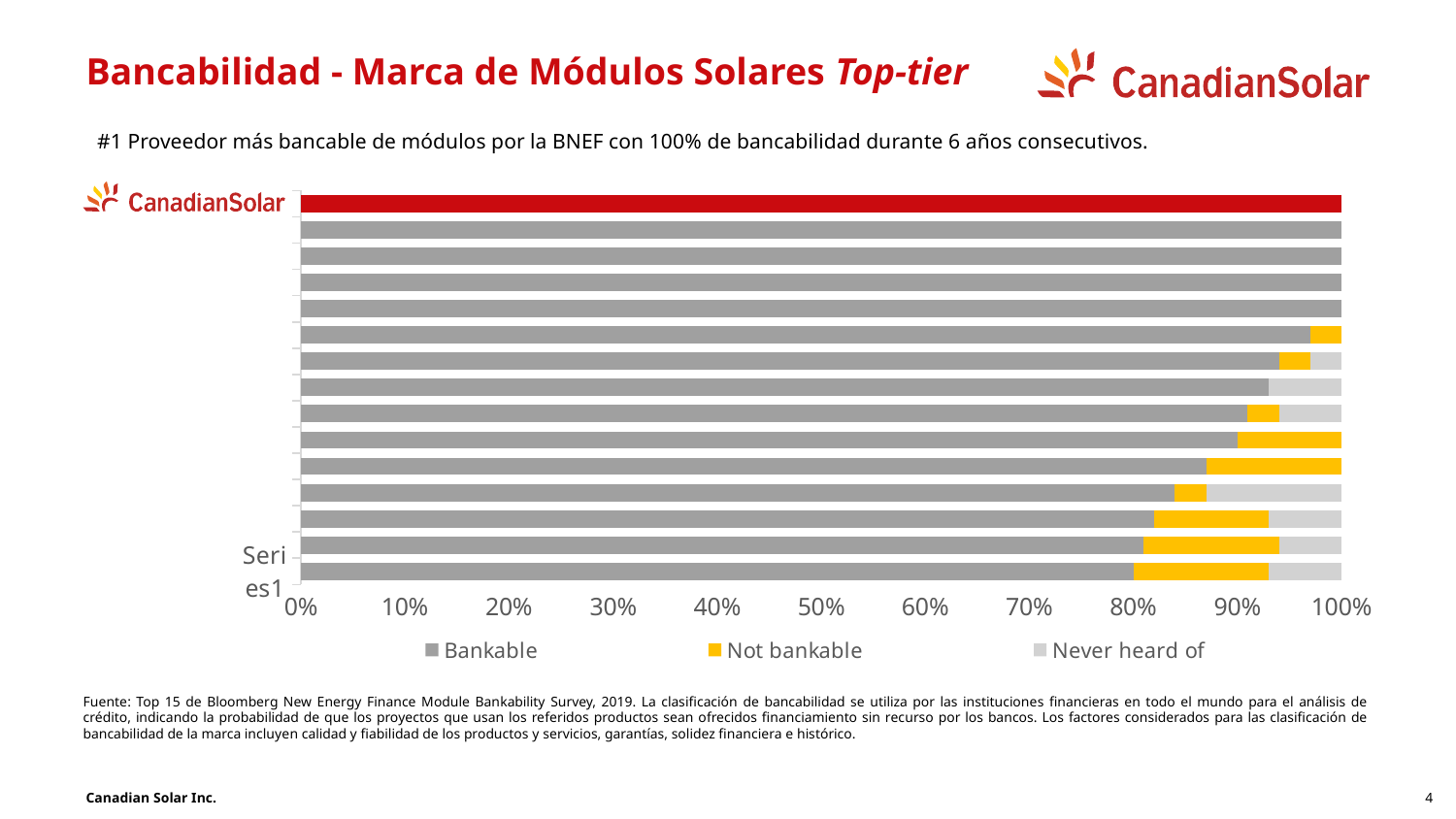
Is the Bankable value for the bottom bar (Series1) greater or less than 90%? less How many bars (module brands) are plotted in the chart? 15 Is the Bankable share of the top bar larger or smaller than that of the bottom bar? Larger Is the Bankable value for the bottom bar (Series1) greater or less than 70%? greater What are the three series named in the chart legend? Bankable, Not bankable, Never heard of Does the Bankable share rise or fall moving from the top bar to the bottom bar? Fall How many series does the chart legend list? 3 What is the Bankable value for the top bar, labelled with the Canadian Solar logo? 100% What kind of chart is shown on the slide? Stacked bar chart What is the maximum value shown on the horizontal axis? 100% Which bar has the lowest Bankable share? The bottom bar (Series1)